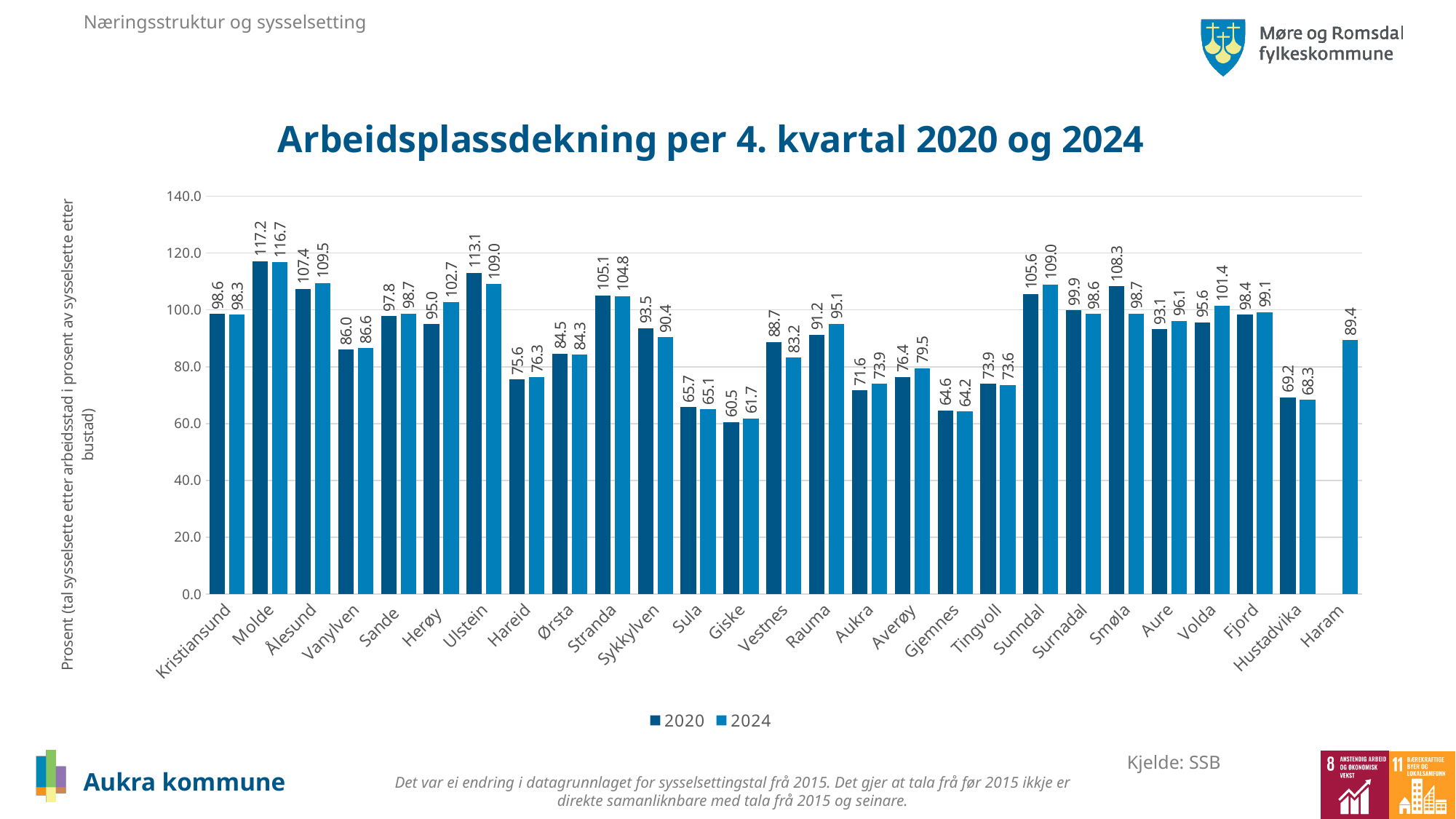
What is the difference between the 2024 and 2020 values for Herøy? 7.7 What is the difference between the 2020 and 2024 values for Smøla? 9.6 What is the 2024 value for Haram? 89.4 Which is larger for Ulstein, the 2020 value or the 2024 value? 2020 What is the 2024 value for Herøy? 102.7 Is the 2020 value for Sunndal greater or less than 100.0? greater What kind of chart is shown on the slide? Bar chart Which municipality has the lowest 2024 value? Giske What is the 2020 value for Molde? 117.2 Which municipality has the highest 2020 value? Molde How many series does the legend list? 2 How many municipalities are shown on the x axis? 27